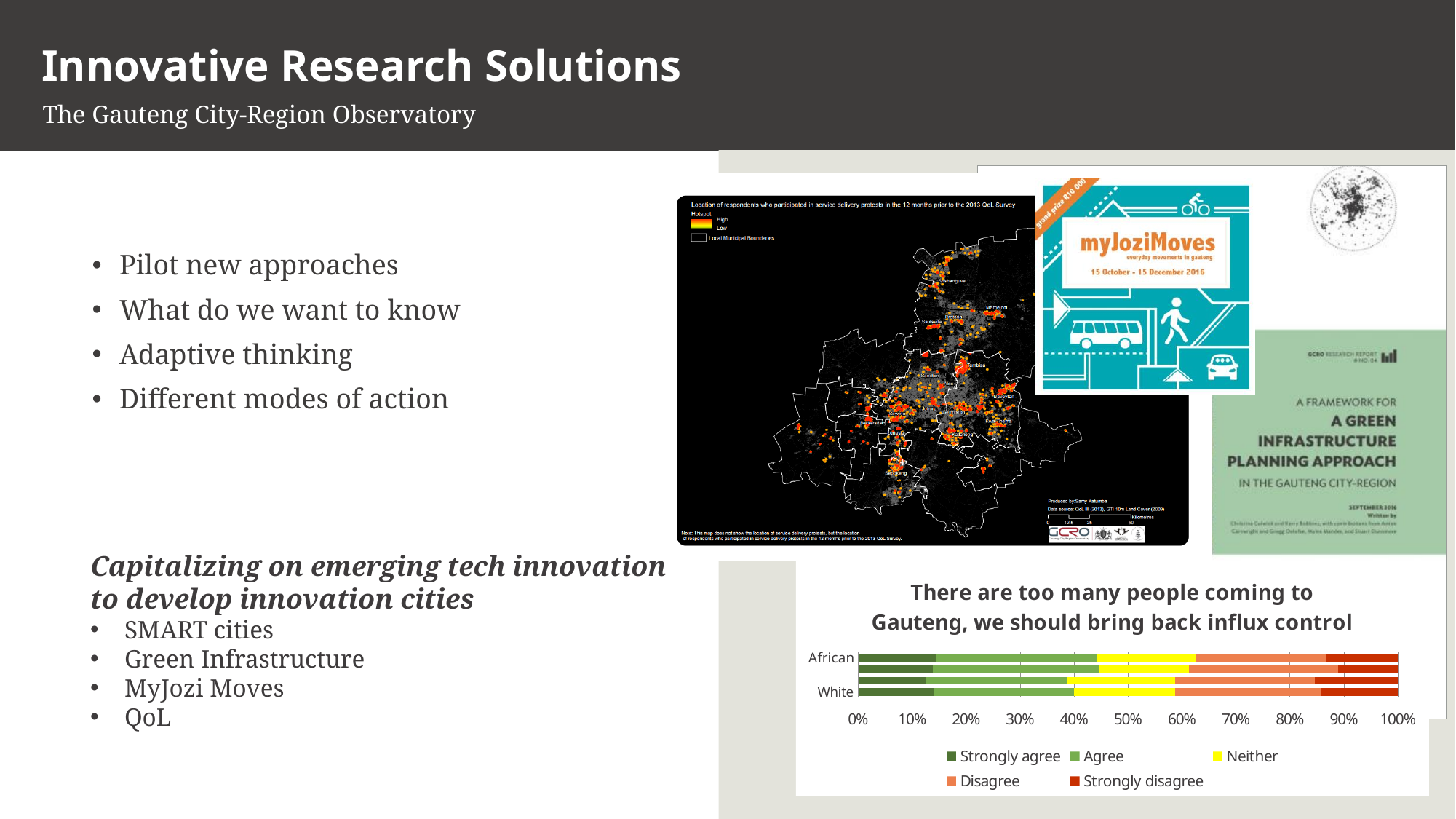
In the bottom-right chart, is the combined Strongly agree and Agree share for African greater or less than 50%? less In the bottom-right chart, is the Strongly disagree segment for White greater or less than 20%? less How many categories (bars) does the chart at the bottom right show? 2 In the bottom-right chart, is the Strongly agree segment for African greater or less than 20%? less What kind of chart is shown at the bottom right of the slide? Stacked bar chart What is the maximum value shown on the x axis of the bottom-right chart? 100% Which two categories are plotted on the bottom-right chart? African and White How many series does the legend of the bottom-right chart list? 5 What is the title of the chart at the bottom right of the slide? There are too many people coming to Gauteng, we should bring back influx control